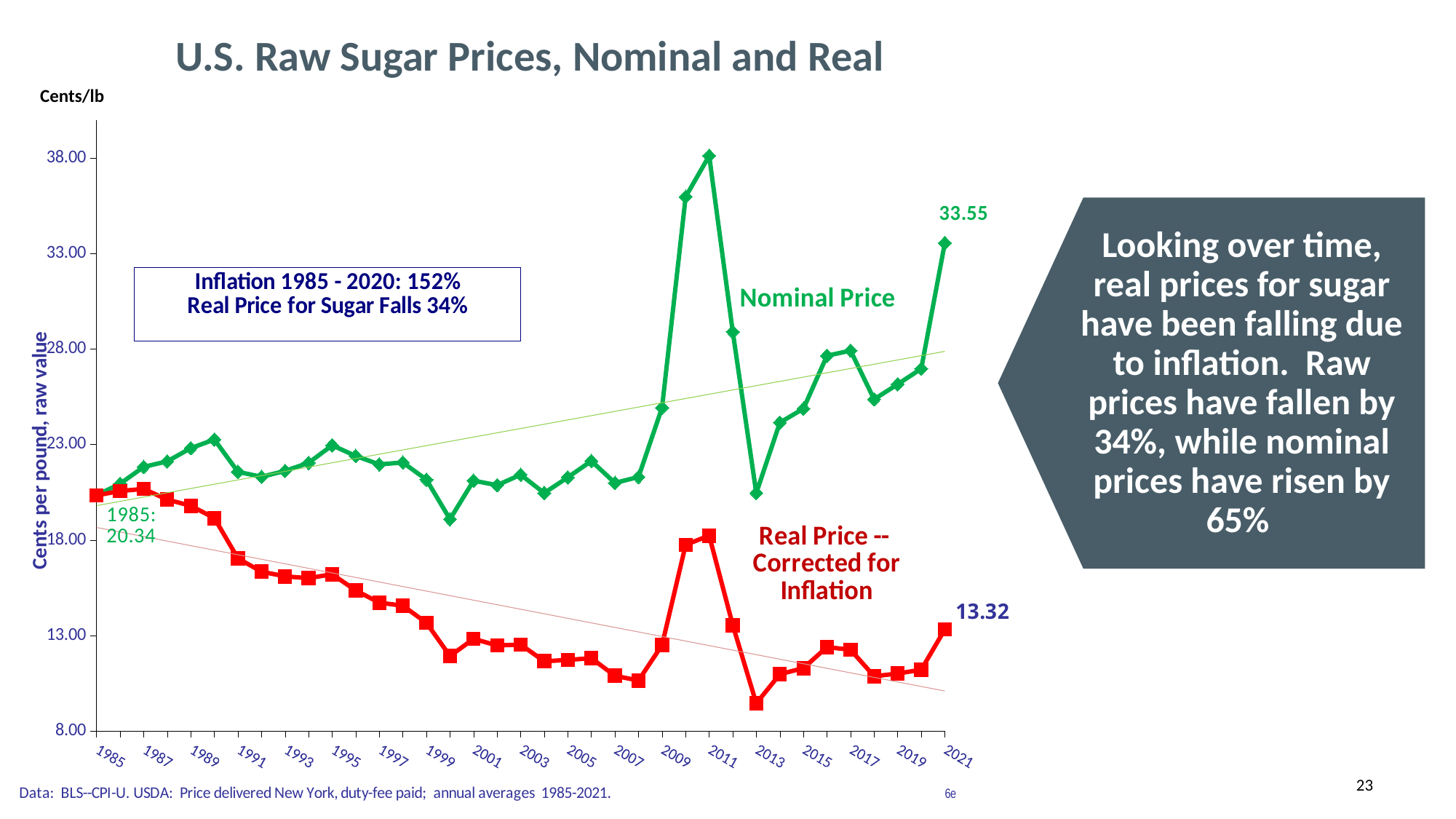
What was the raw sugar price in 1985 according to the data label? 20.34 What kind of chart is shown on the slide? line chart In 2021, which is larger: the nominal price or the real price? Nominal Price How many data series are plotted on the chart? 2 In which year does the Nominal Price line reach its highest point? 2011 Is the real price for 2013 greater or less than 13.00? less Does the Real Price line generally rise or fall from 1985 to 2021? fall Is the nominal price for 2011 greater or less than 33.00? greater What is the nominal price of raw sugar in 2021 according to the data label? 33.55 By how much did the nominal price in 2021 (33.55) exceed the 1985 price (20.34)? 13.21 What is the difference between the nominal price and the real price in 2021? 20.23 What is the real (inflation-corrected) price of raw sugar in 2021 according to the data label? 13.32